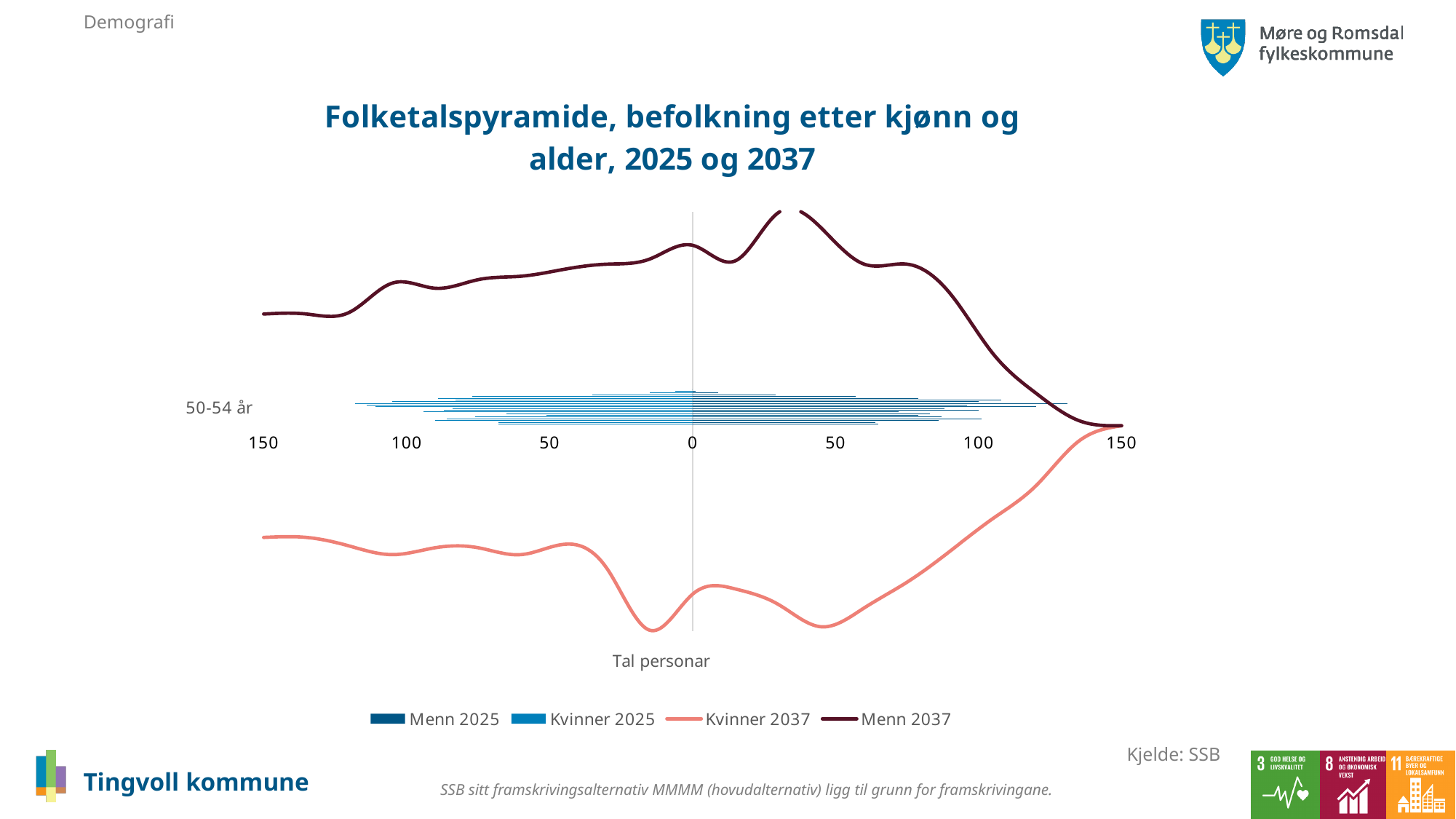
How many series does the legend list? 4 What is the title of the chart? Folketalspyramide, befolkning etter kjønn og alder, 2025 og 2037 What is the label on the horizontal axis of the chart? Tal personar What source is cited for the chart? SSB Which series are shown in the legend? Menn 2025, Kvinner 2025, Kvinner 2037, Menn 2037 Which age group label is readable on the vertical axis of the chart? 50-54 år What is the highest value shown on the horizontal axis of the chart? 150